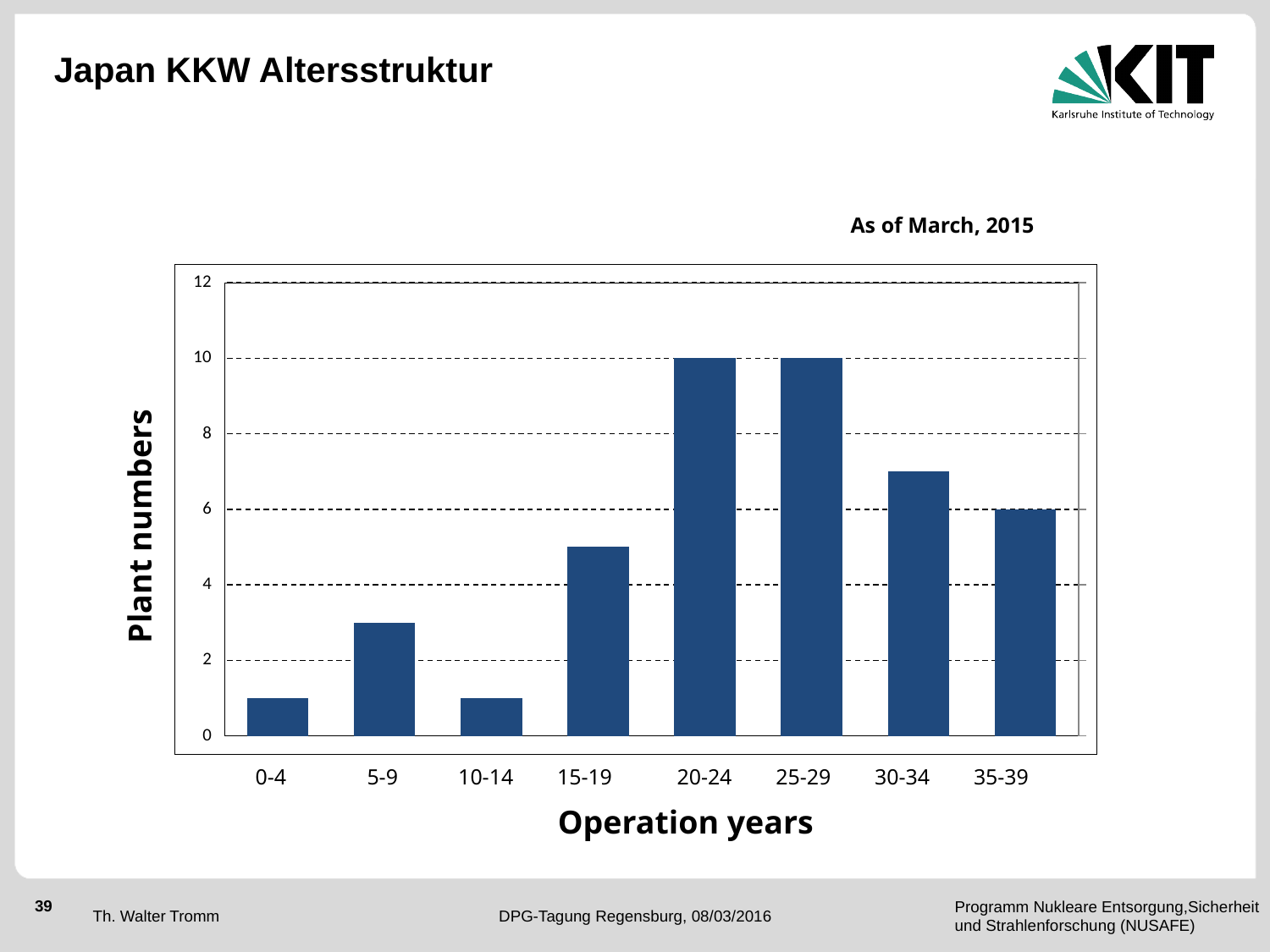
What kind of chart is shown on the slide? bar chart What is the difference between the plant numbers for 20-24 and 35-39 operation years? 4 Is the plant number for the 5-9 category greater or less than 4? less Do plant numbers rise or fall from the 10-14 category to the 20-24 category? rise What is the plant number for the 20-24 operation years category? 10 What is the label of the y axis? Plant numbers What is the plant number for the 25-29 operation years category? 10 How many operation-year categories are shown on the x axis? 8 Is the plant number for the 15-19 category greater or less than 6? less What is the plant number for the 35-39 operation years category? 6 Which category has more plants, 15-19 or 5-9 operation years? 15-19 Is the plant number for the 30-34 category greater or less than 6? greater